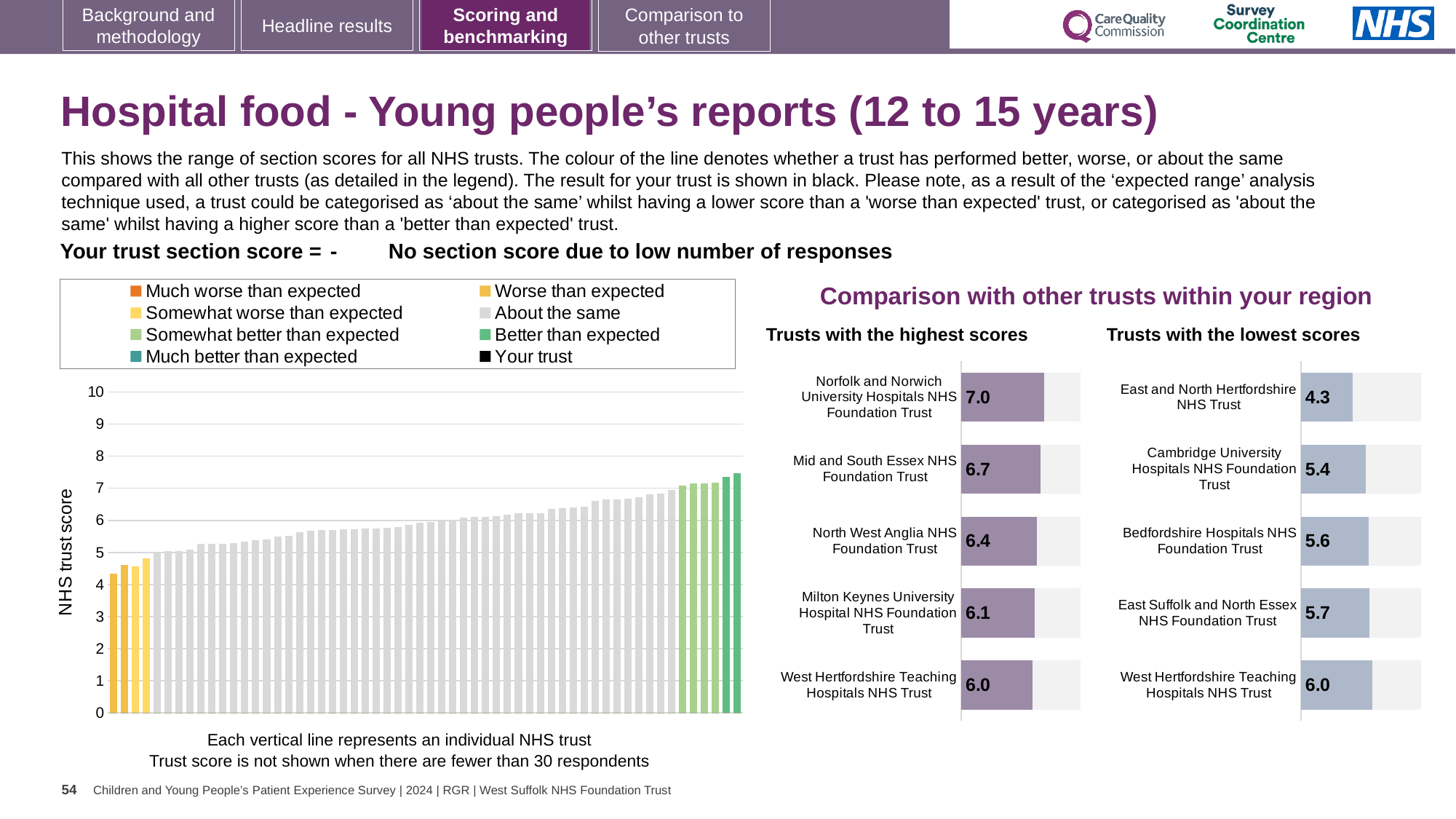
In the left-hand chart showing the range of section scores, is the value of the lowest bar greater or less than 5? less In the 'Trusts with the lowest scores' chart, which trust has the lowest score? East and North Hertfordshire NHS Trust In the 'Trusts with the highest scores' chart, what is the score for Norfolk and Norwich University Hospitals NHS Foundation Trust? 7.0 In the 'Trusts with the highest scores' chart, what is the score for North West Anglia NHS Foundation Trust? 6.4 How many trusts are listed in the 'Trusts with the lowest scores' chart? 5 In the 'Trusts with the highest scores' chart, what is the difference between the scores of Norfolk and Norwich University Hospitals NHS Foundation Trust and Mid and South Essex NHS Foundation Trust? 0.3 In the 'Trusts with the lowest scores' chart, which has the larger score: Cambridge University Hospitals NHS Foundation Trust or East Suffolk and North Essex NHS Foundation Trust? East Suffolk and North Essex NHS Foundation Trust In the 'Trusts with the lowest scores' chart, what is the score for East and North Hertfordshire NHS Trust? 4.3 In the left-hand chart showing the range of section scores, do the bar values rise or fall from left to right? rise In the 'Trusts with the lowest scores' chart, what is the score for Bedfordshire Hospitals NHS Foundation Trust? 5.6 In the 'Trusts with the highest scores' chart, which trust has the highest score? Norfolk and Norwich University Hospitals NHS Foundation Trust How many entries does the legend of the left-hand chart list? 8